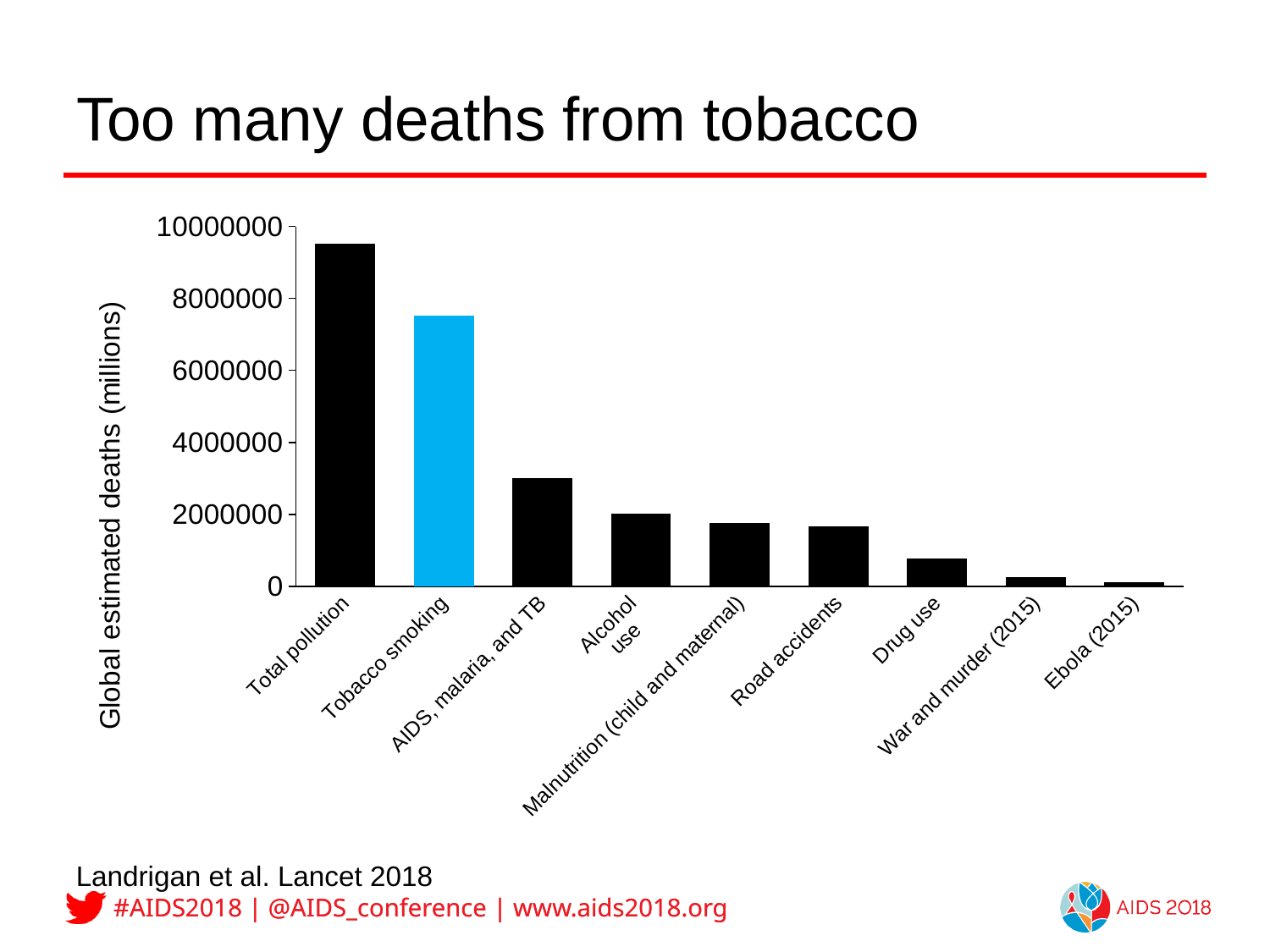
Is the value for Total pollution greater or less than 8000000? greater Which is larger, the value for Drug use or the value for War and murder (2015)? Drug use Which is larger, the value for Total pollution or the value for Tobacco smoking? Total pollution Do the values rise or fall moving from left to right along the x axis? Fall Which category's bar is coloured blue rather than black? Tobacco smoking How many categories are plotted on the x axis of the chart? 9 Is the value for Tobacco smoking greater or less than 8000000? less Which is larger, the value for AIDS, malaria, and TB or the value for Alcohol use? AIDS, malaria, and TB What kind of chart is shown on the slide? Bar chart Which category has the lowest number of global estimated deaths? Ebola (2015) Which category has the highest number of global estimated deaths? Total pollution Is the value for AIDS, malaria, and TB greater or less than 4000000? less